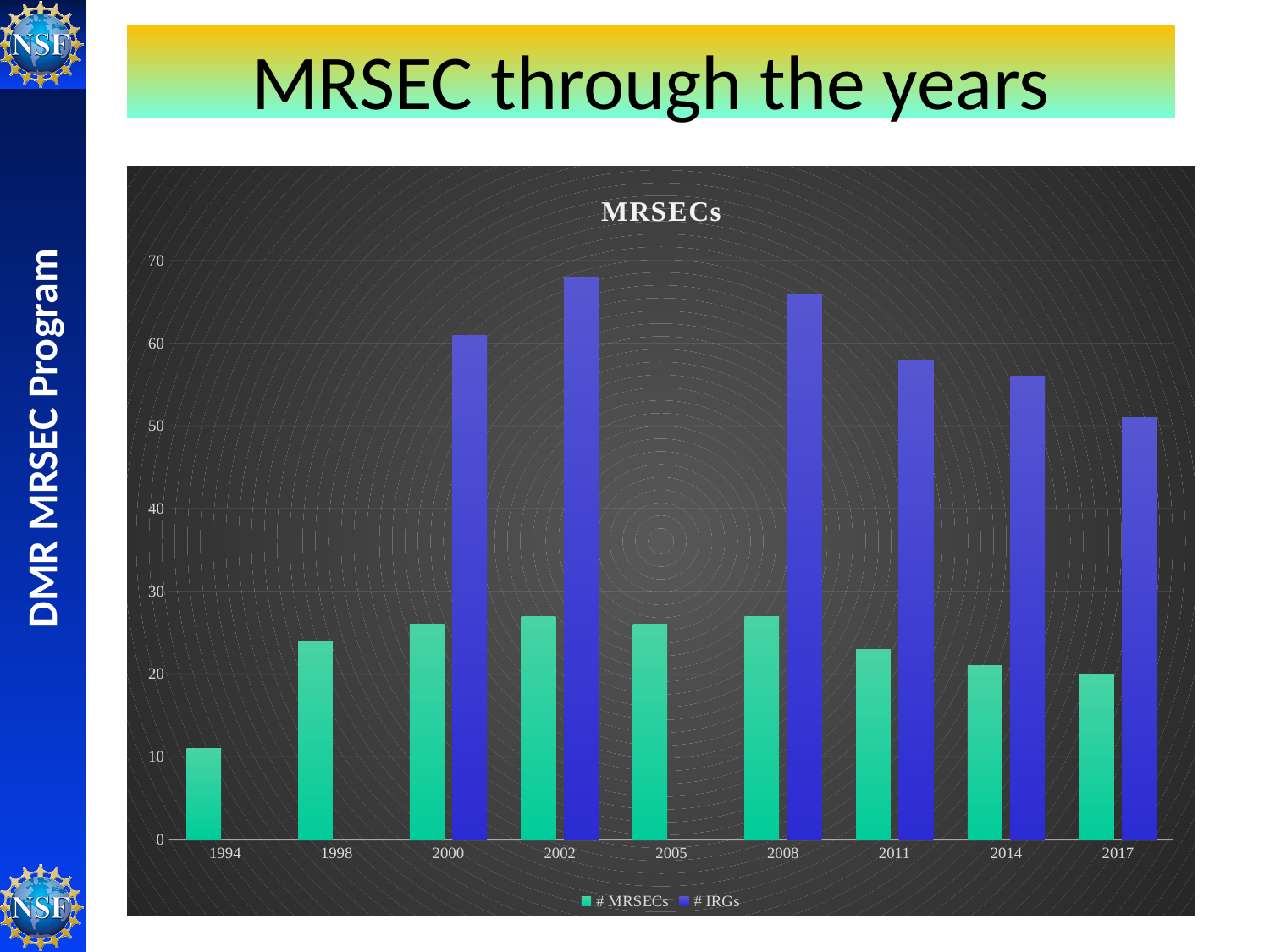
Is the value for # MRSECs in 1994 greater or less than 20? less Which is larger, # IRGs in 2000 or # IRGs in 2017? 2000 Is the value for # IRGs in 2002 greater or less than 60? greater How many years are shown along the x axis? 9 Is the value for # MRSECs in 2011 greater or less than 20? greater Which year has the lowest value for # MRSECs? 1994 Which year has the lowest value for # IRGs among the years where it is plotted? 2017 What kind of chart is shown on the slide? bar chart How many series does the legend list? 2 Do the # IRGs values rise or fall from 2008 to 2017? fall What is the title of the chart? MRSECs